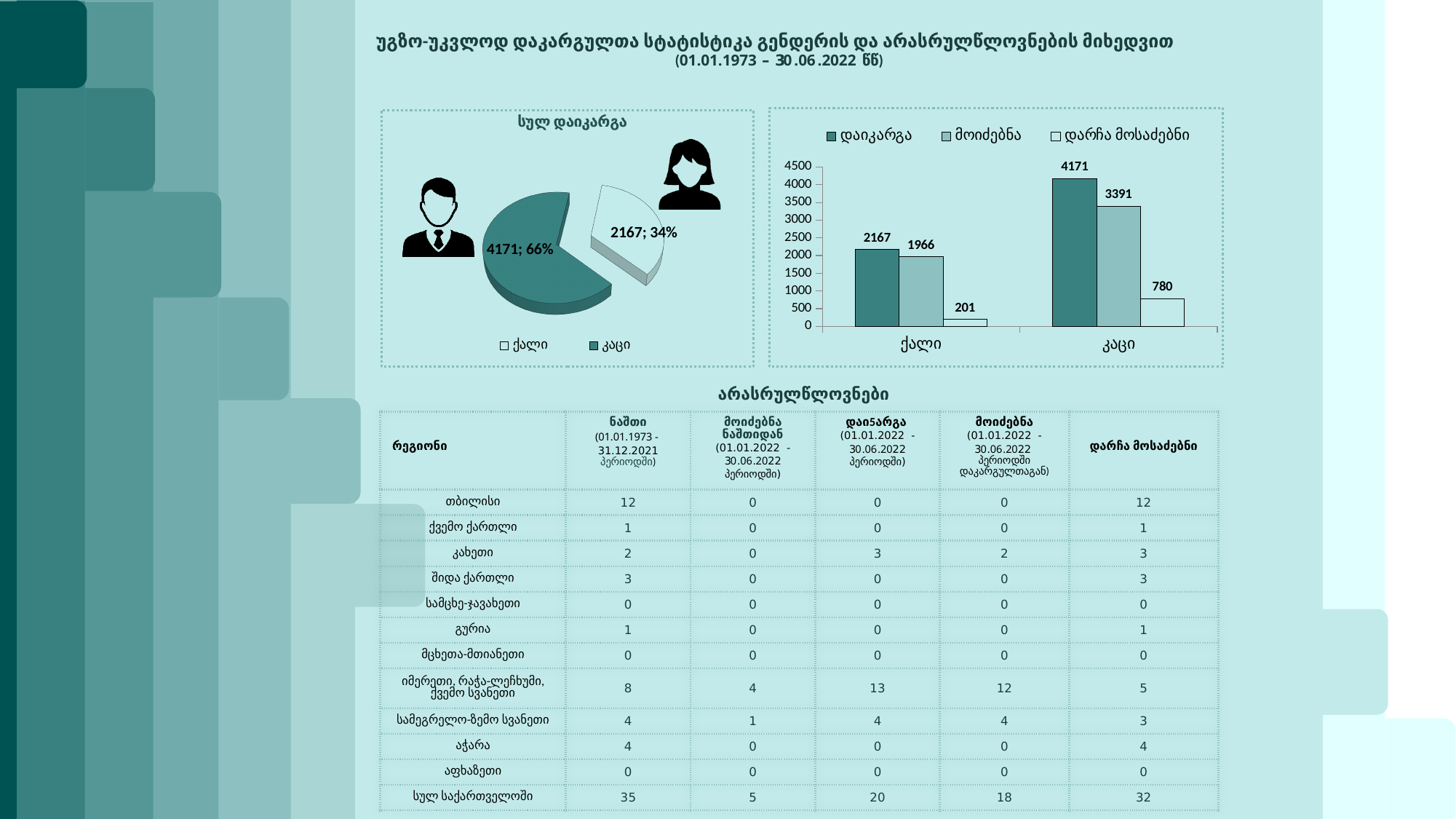
In the bar chart on the right, what is the value of დარჩა მოსაძებნი for კაცი? 780 In the bar chart on the right, what is the value of დაიკარგა for კაცი? 4171 In the bar chart on the right, how many series does the legend list? 3 What kind of chart is the one on the left titled "სულ დაიკარგა"? pie chart In the bar chart on the right, is the value of მოიძებნა for კაცი greater or less than 3000? greater In the bar chart on the right, which series has the lowest value for ქალი? დარჩა მოსაძებნი In the pie chart titled "სულ დაიკარგა", what value and share are shown for კაცი? 4171; 66% In the pie chart titled "სულ დაიკარგა", which slice is larger, ქალი or კაცი? კაცი What kind of chart is the one on the right of the slide? bar chart In the bar chart on the right, what is the difference between დაიკარგა and მოიძებნა for ქალი? 201 In the pie chart titled "სულ დაიკარგა", what share of the pie does ქალი have? 34% In the bar chart on the right, what is the value of მოიძებნა for ქალი? 1966